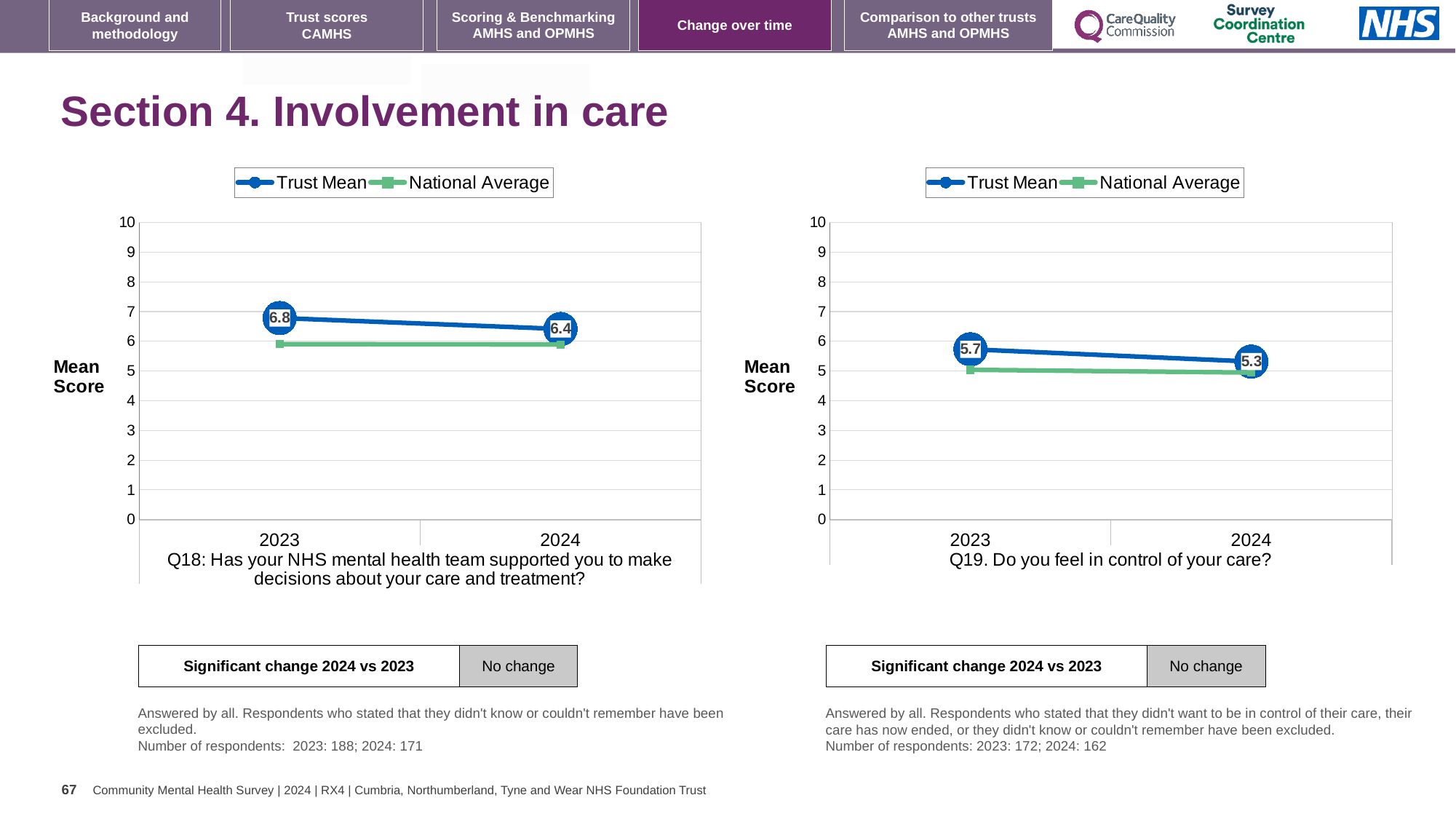
How many years are plotted on the x axis of the Q19 chart on the right? 2 In the Q19 chart on the right, does the Trust Mean rise or fall from 2023 to 2024? fall In the Q19 chart on the right, what is the Trust Mean score for 2023? 5.7 In the Q18 chart on the left, what is the Trust Mean score for 2024? 6.4 In the Q18 chart on the left, by how much did the Trust Mean change from 2023 to 2024? 0.4 In the Q18 chart on the left, what is the Trust Mean score for 2023? 6.8 How many series does the legend of the Q18 chart on the left list? 2 In the Q18 chart on the left, which is larger in 2023: the Trust Mean or the National Average? Trust Mean In the Q19 chart on the right, what is the Trust Mean score for 2024? 5.3 What colour is the National Average line in the Q19 chart on the right? green What kind of chart is the Q18 chart on the left? line chart In the Q19 chart on the right, is the National Average for 2023 greater or less than 6? less